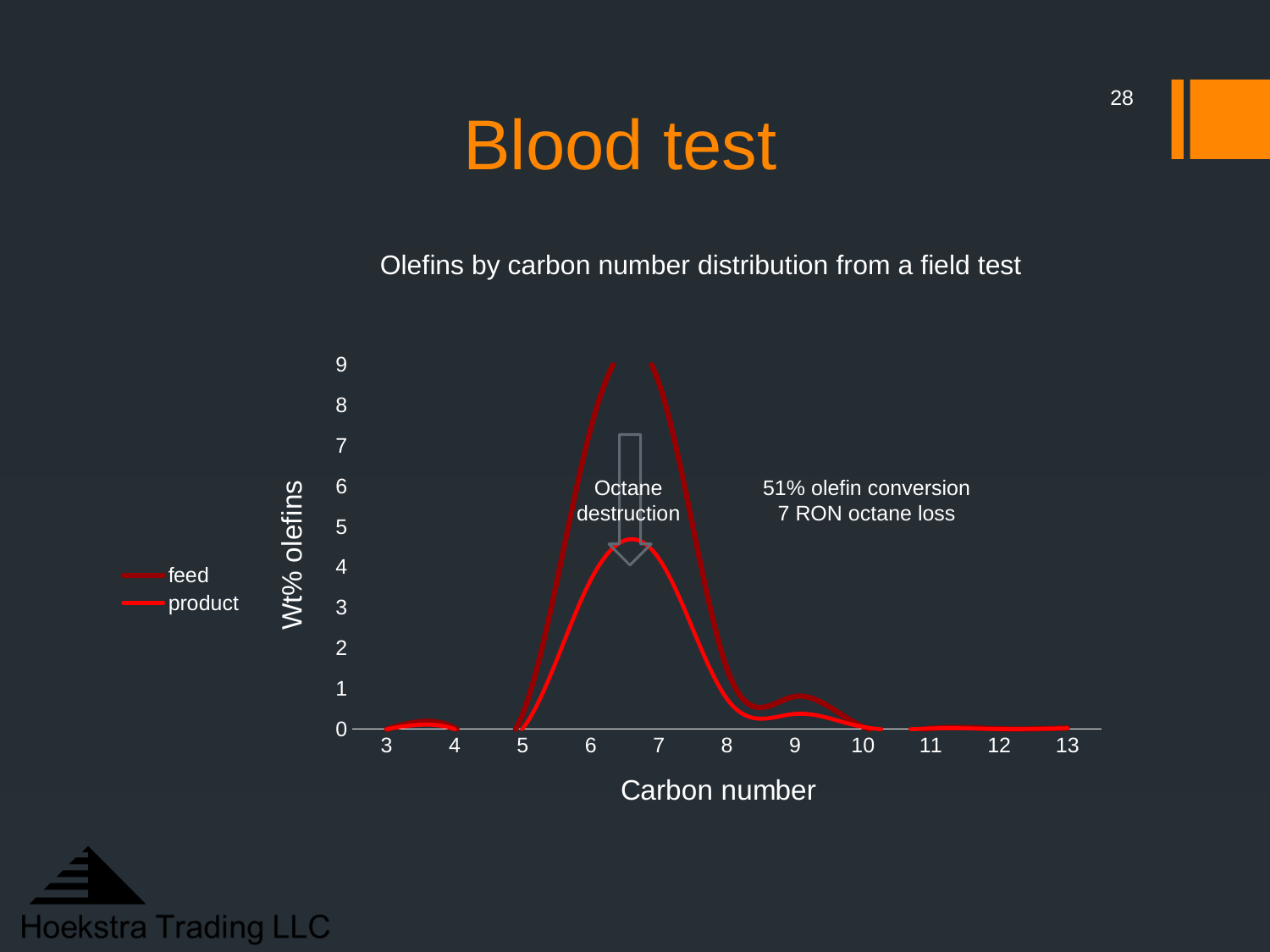
How many series does the legend list? 2 Is the value for product at carbon number 5 greater or less than 1? less Is the value for product at carbon number 6 greater or less than 4? less Which series has the higher value at carbon number 6, feed or product? feed What kind of chart is shown on the slide? line chart How many carbon number ticks are shown on the x axis? 11 What is the title of the chart? Olefins by carbon number distribution from a field test What are the two series named in the legend? feed and product Is the value for feed at carbon number 6 greater or less than 5? greater Do the feed values rise or fall from carbon number 7 to carbon number 9? fall Which series has the higher value at carbon number 7, feed or product? feed